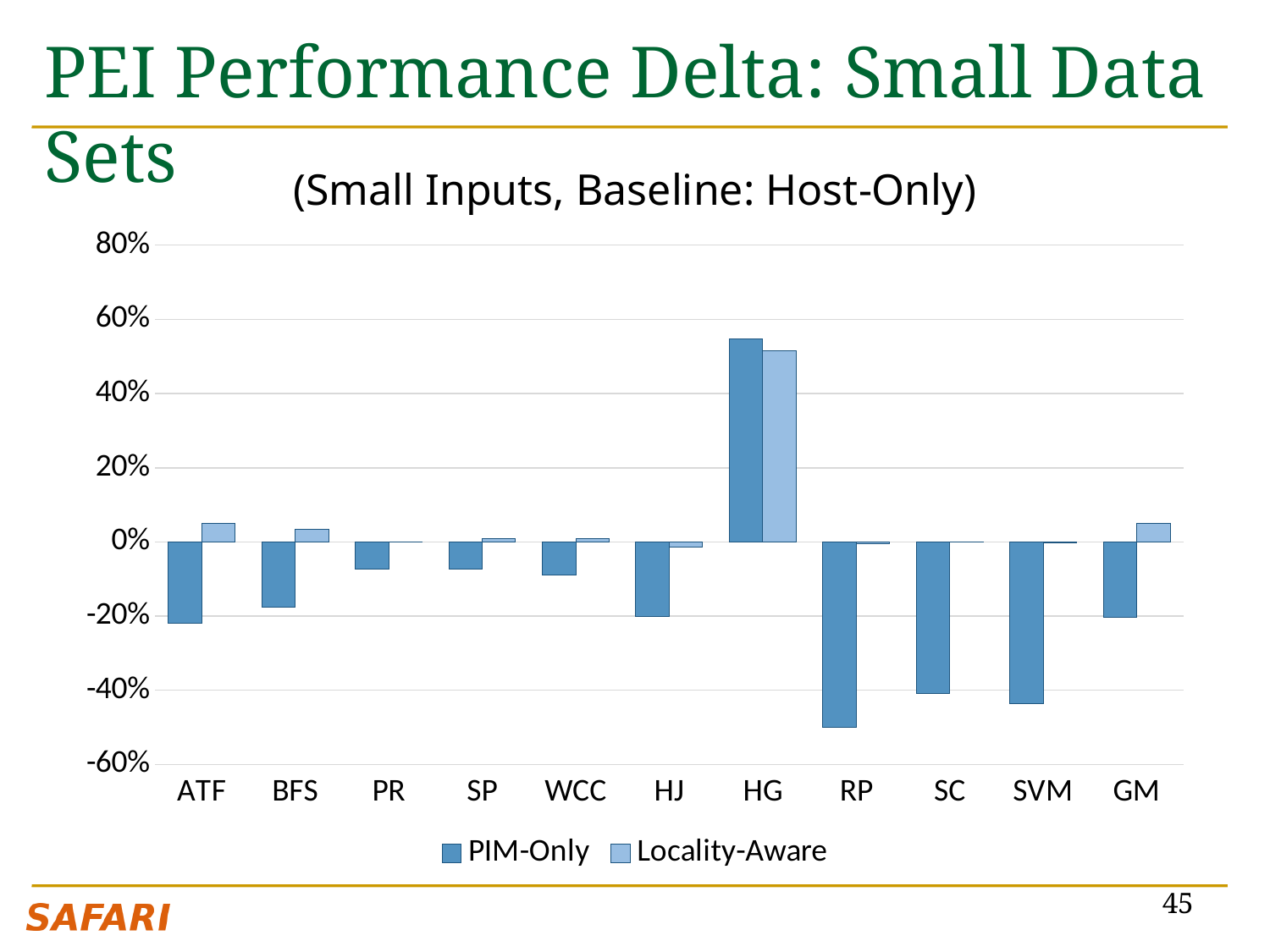
How many series does the legend list? 2 Is the Locality-Aware value for HG greater or less than 40%? greater Is the PIM-Only value for HG greater or less than 40%? greater For ATF, which series has the larger value, PIM-Only or Locality-Aware? Locality-Aware How many categories are shown on the x axis? 11 Which category has the lowest PIM-Only value? RP What is the subtitle shown above the chart? (Small Inputs, Baseline: Host-Only) Is the PIM-Only value for SVM greater or less than -40%? less What kind of chart is shown on the slide? bar chart Which category has the highest PIM-Only value? HG Which category has the highest Locality-Aware value? HG